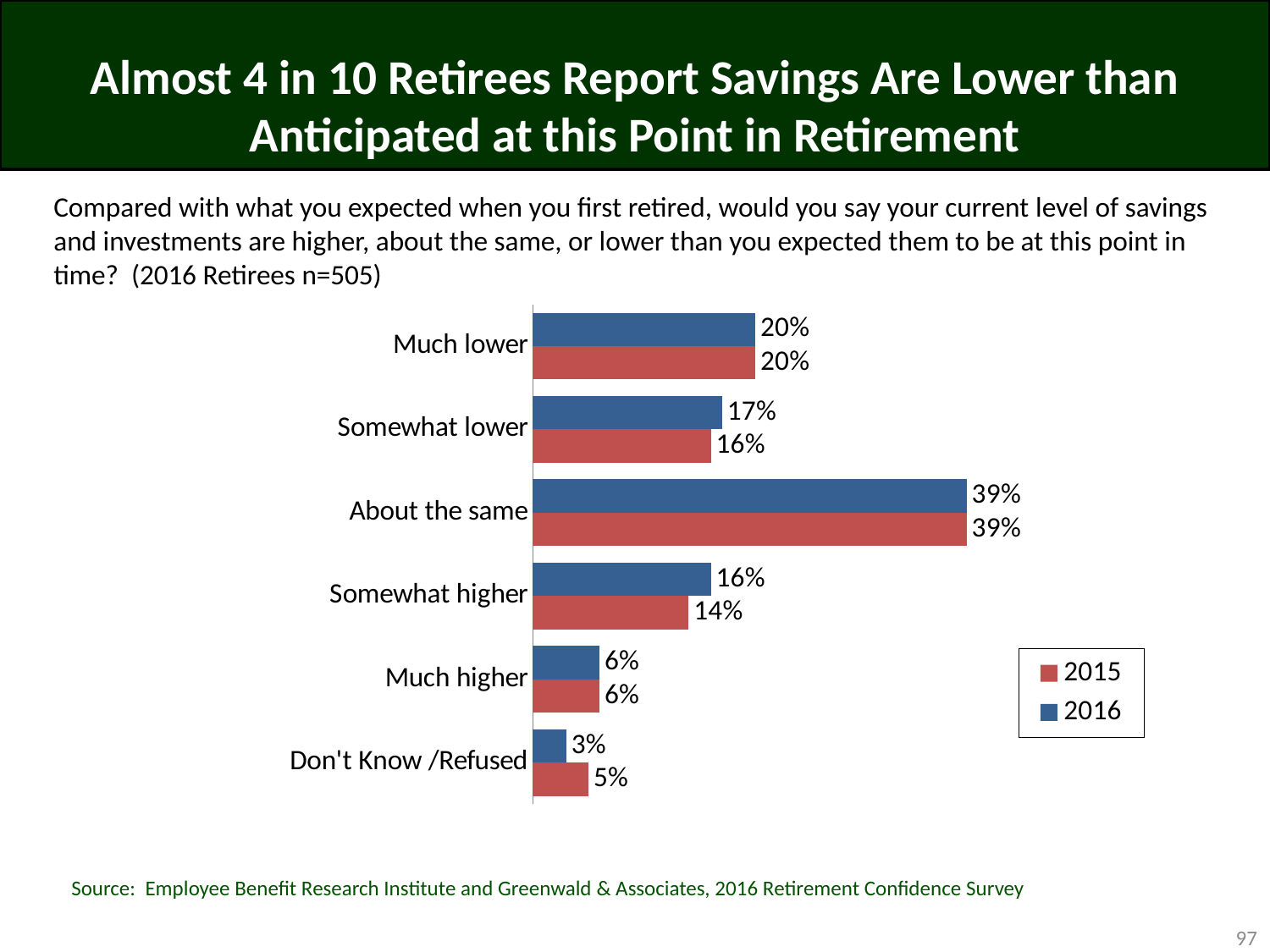
Which is larger for "Don't Know /Refused": the 2015 value or the 2016 value? 2015 What is the 2015 value for "Somewhat lower"? 16% How many series does the legend list? 2 Which category has the highest 2016 value? About the same What is the 2016 value for "Don't Know /Refused"? 3% What is the difference between the 2016 and 2015 values for "Somewhat higher"? 2% What is the 2015 value for "Somewhat higher"? 14% How many categories are shown on the chart? 6 Which category has the lowest 2016 value? Don't Know /Refused What is the 2016 value for "About the same"? 39% What kind of chart is shown on the slide? Bar chart Which colour represents the 2016 series in the legend? Blue